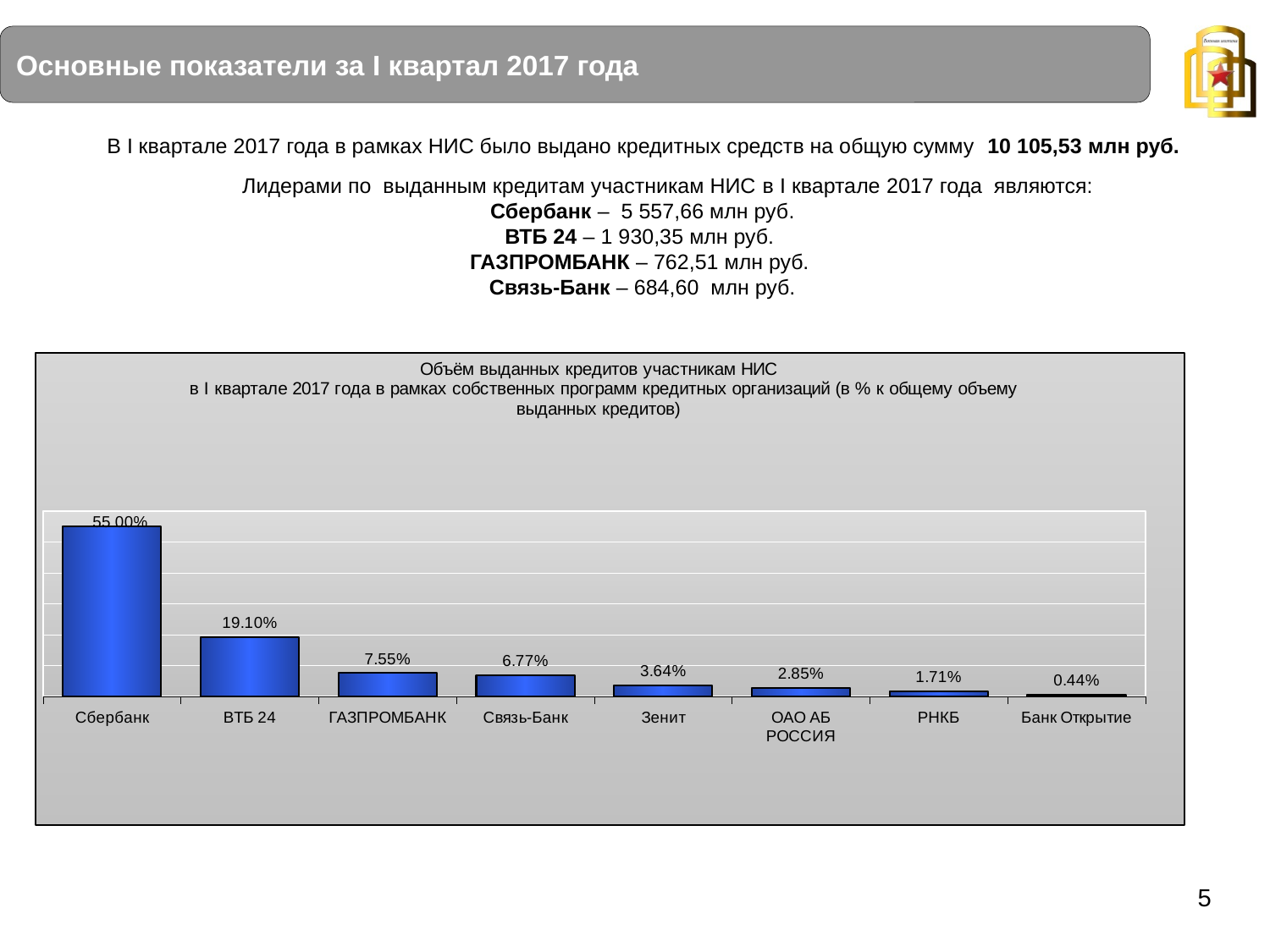
What is the value for Сбербанк? 55.00% What kind of chart is shown on the slide? Bar chart Which bank has the lowest value? Банк Открытие What is the value for ВТБ 24? 19.10% Do the values rise or fall from left to right across the chart? Fall What is the difference between the values for Сбербанк and ВТБ 24? 35.90% Which bank has the highest value? Сбербанк Which is larger, the value for ОАО АБ РОССИЯ or the value for РНКБ? ОАО АБ РОССИЯ How many banks are shown in the chart? 8 What is the value for Банк Открытие? 0.44% What is the difference between the values for ГАЗПРОМБАНК and Связь-Банк? 0.78% What is the value for Зенит? 3.64%